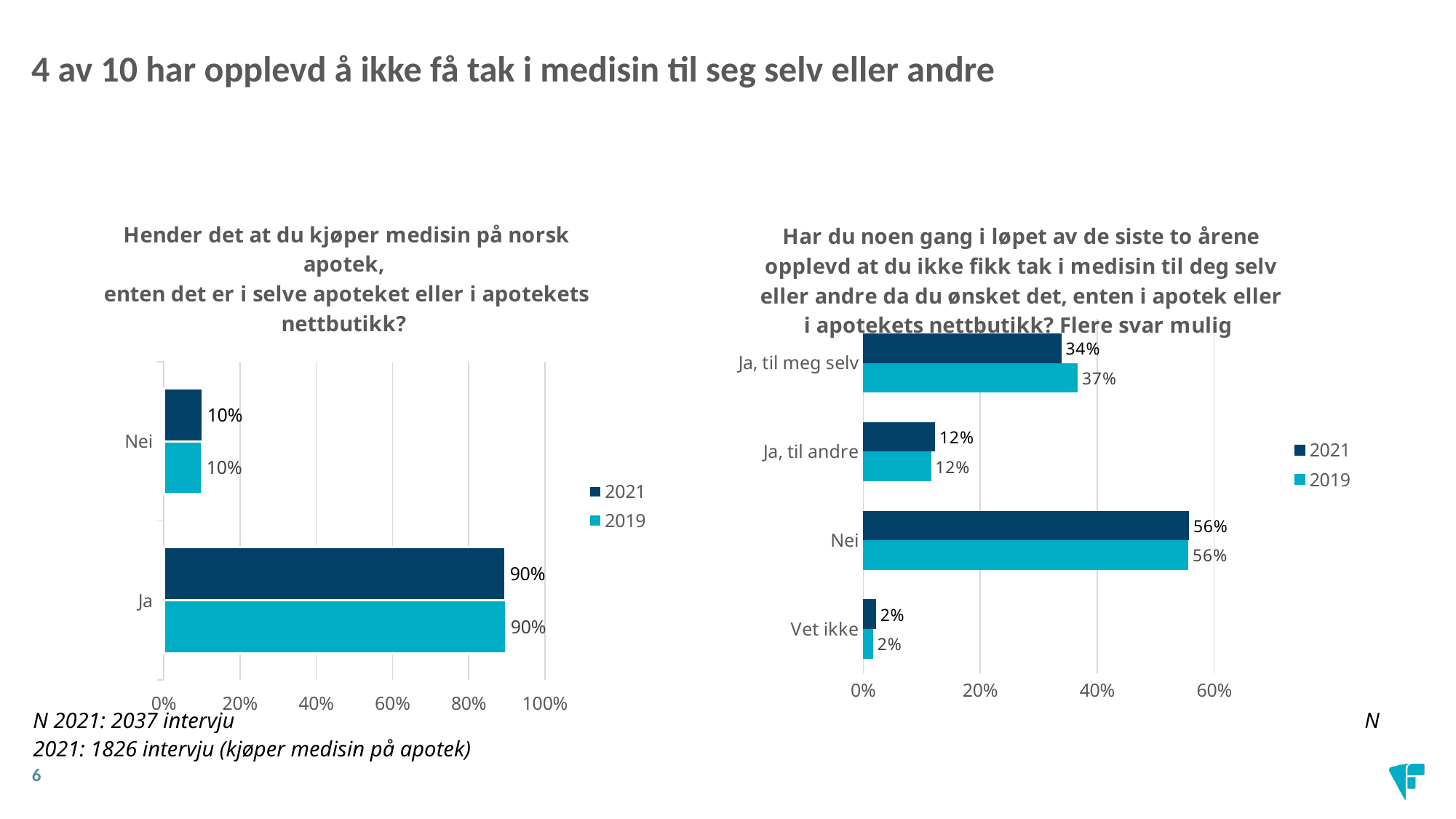
In the right chart ("Har du noen gang i løpet av de siste to årene..."), which category has the highest value in 2021? Nei In the right chart ("Har du noen gang i løpet av de siste to årene..."), what is the difference between the 2019 and 2021 values for "Ja, til meg selv"? 3% In the left chart ("Hender det at du kjøper medisin på norsk apotek..."), what is the difference between the 2021 values for "Ja" and "Nei"? 80% In the left chart ("Hender det at du kjøper medisin på norsk apotek..."), what kind of chart is it? Bar chart In the right chart ("Har du noen gang i løpet av de siste to årene..."), what is the value for "Ja, til meg selv" in 2019? 37% In the left chart ("Hender det at du kjøper medisin på norsk apotek..."), what is the value for "Nei" in 2019? 10% In the right chart ("Har du noen gang i løpet av de siste to årene..."), which category has the lowest value in 2019? Vet ikke In the left chart ("Hender det at du kjøper medisin på norsk apotek..."), how many series does the legend list? 2 In the right chart ("Har du noen gang i løpet av de siste to årene..."), what is the value for "Nei" in 2021? 56% In the right chart ("Har du noen gang i løpet av de siste to årene..."), which is larger: the 2021 value for "Ja, til meg selv" or the 2021 value for "Ja, til andre"? Ja, til meg selv In the left chart ("Hender det at du kjøper medisin på norsk apotek..."), what is the value for "Ja" in 2021? 90% In the right chart ("Har du noen gang i løpet av de siste to årene..."), how many categories are shown? 4